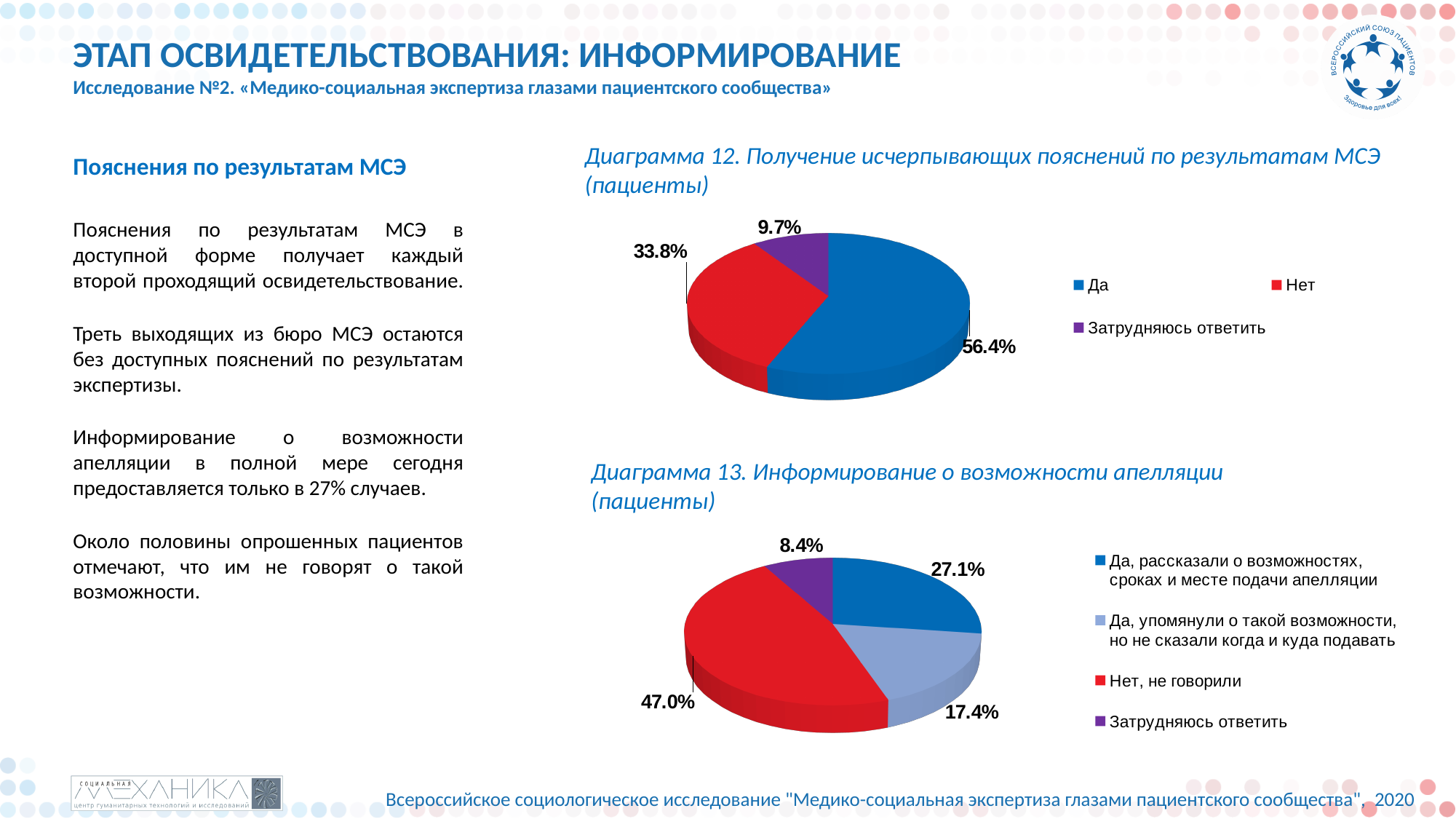
In Диаграмма 12, what is the difference between the «Да» and «Нет» shares? 22.6% In Диаграмма 12, which answer has the smallest share? Затрудняюсь ответить In Диаграмма 13, what colour is the slice for «Нет, не говорили»? Red In Диаграмма 13, what share of patients answered «Да, упомянули о такой возможности, но не сказали когда и куда подавать»? 17.4% In Диаграмма 12, what share of patients answered «Да»? 56.4% What type of chart is Диаграмма 12? Pie chart In Диаграмма 12, what share of patients answered «Нет»? 33.8% In Диаграмма 13, what share of patients answered «Нет, не говорили»? 47.0% In Диаграмма 13, how many slices does the pie have? 4 In Диаграмма 13, which answer has the largest share? Нет, не говорили In Диаграмма 13, which is larger: the share for «Да, рассказали о возможностях, сроках и месте подачи апелляции» or for «Затрудняюсь ответить»? Да, рассказали о возможностях, сроках и месте подачи апелляции In Диаграмма 12, how many answer categories does the legend list? 3